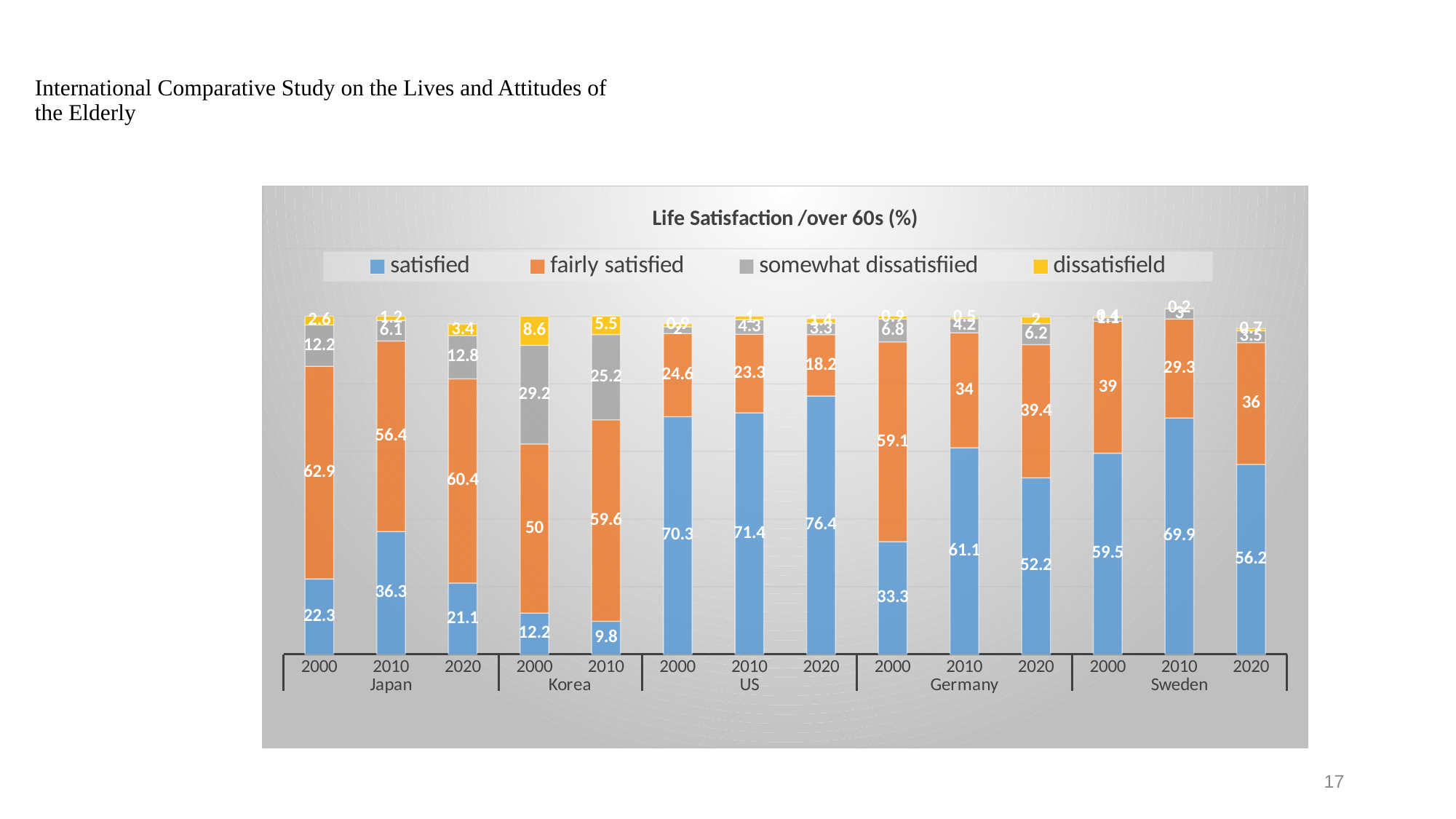
How many series does the legend list? 4 What is the 'fairly satisfied' value for Japan in 2000? 62.9 What kind of chart is shown? Stacked bar chart What is the 'somewhat dissatisfied' value for Korea in 2000? 29.2 What is the 'satisfied' value for US in 2020? 76.4 Which country and year has the highest 'satisfied' value? US 2020 What is the 'dissatisfied' value for Korea in 2000? 8.6 How many bars are plotted in the chart? 14 Which is larger, the 'satisfied' value for Germany in 2010 or Germany in 2020? Germany 2010 What is the difference between the 'satisfied' values for Japan in 2010 and Japan in 2000? 14 Does the 'satisfied' value for the US rise or fall from 2000 to 2020? Rise Which country and year has the lowest 'satisfied' value? Korea 2010